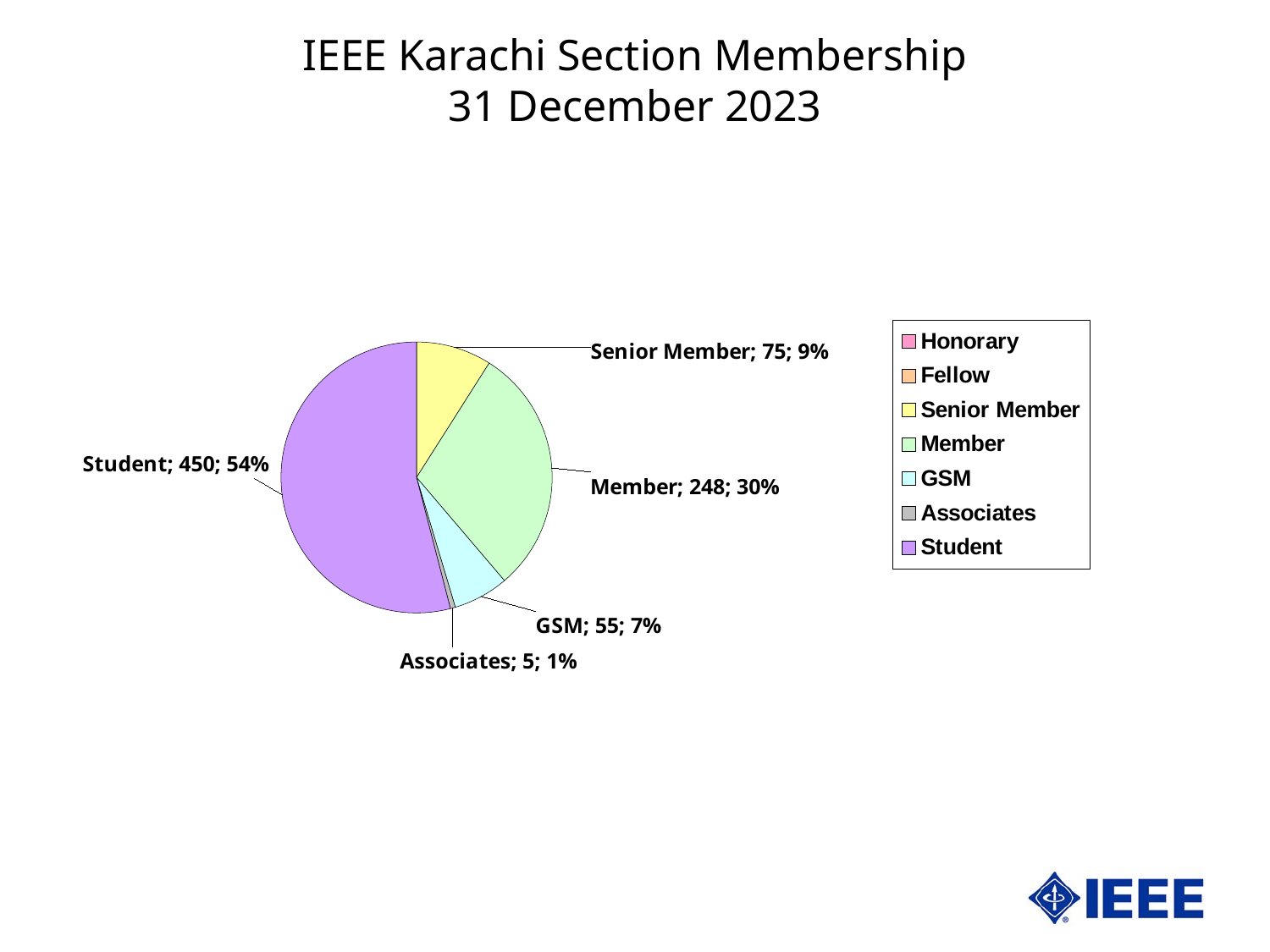
Which labelled slice has the smallest value? Associates What share of the pie does the Member category represent? 30% What share of the pie does the GSM category represent? 7% How many members are in the Senior Member category? 75 Which category has the largest slice of the pie? Student How many members are in the Student category? 450 What kind of chart is shown on the slide? pie chart What colour is the Student slice? purple Which is larger, the Senior Member count or the GSM count? Senior Member How many entries does the legend list? 7 What is the difference between the Student count and the Member count? 202 What is the title of the chart? IEEE Karachi Section Membership 31 December 2023